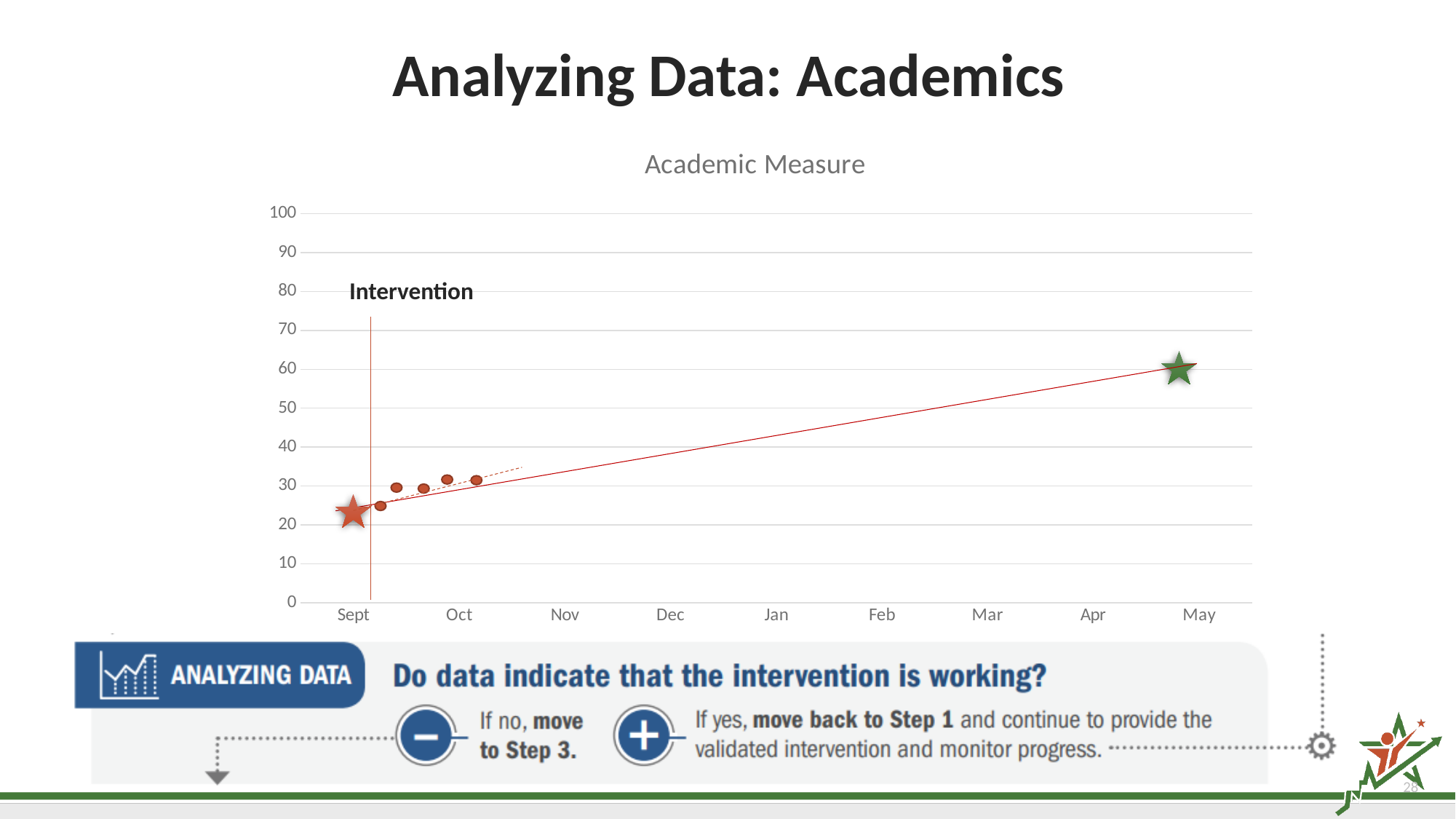
Is the value marked by the green star at May greater or less than 50? greater Does the red trend line rise or fall from Sept to May? rises What is the first month label on the x axis? Sept Is the value marked by the red star at Sept greater or less than 10? greater What is the highest value shown on the y axis? 100 How many month labels are shown on the x axis? 9 Is the value marked by the green star at May greater or less than 70? less Which is larger, the value at the green star (May) or the value at the red star (Sept)? the green star (May) What is the title of the chart? Academic Measure What kind of chart is shown on the slide? line chart